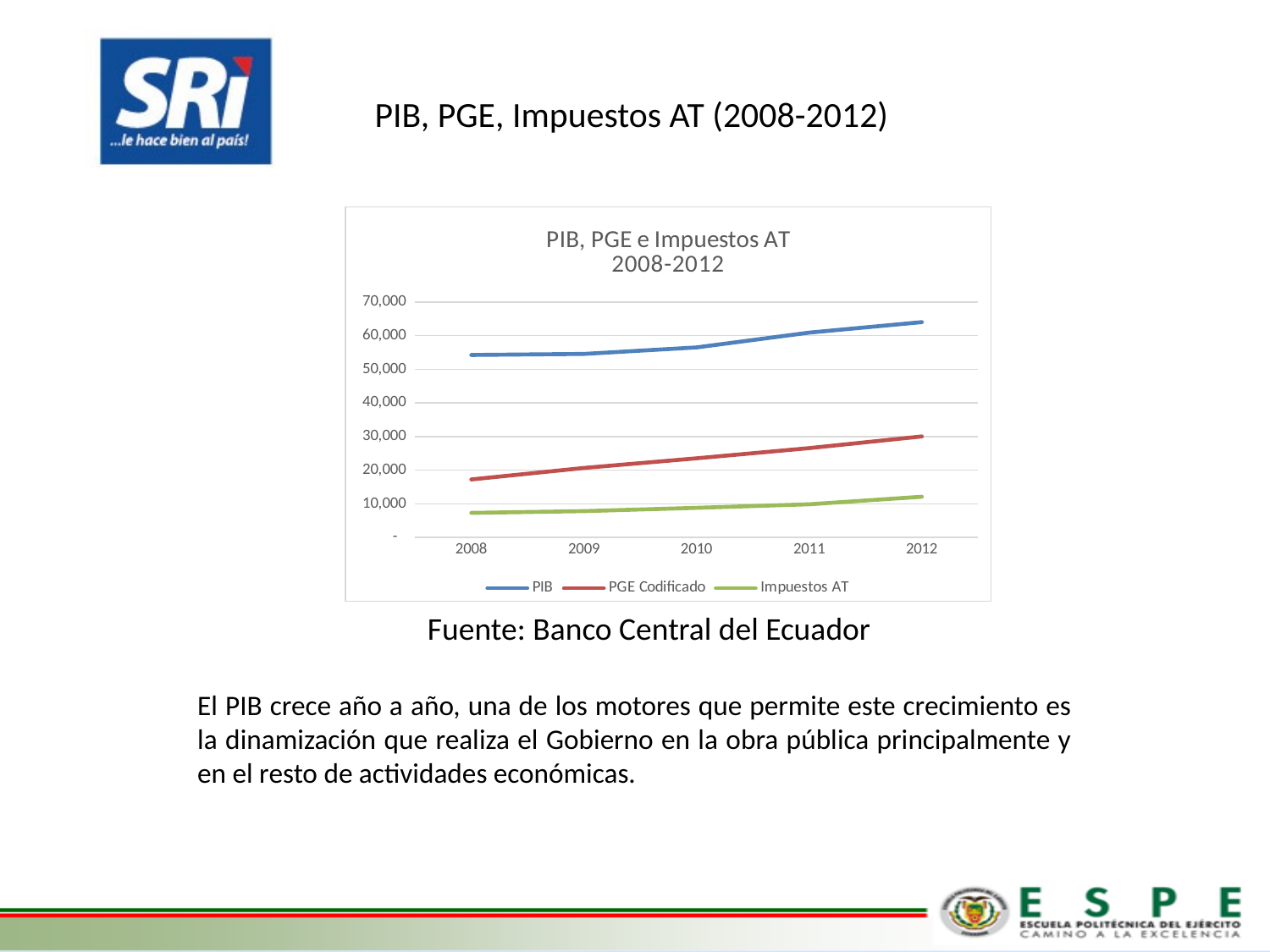
In 2012, which is larger: PIB or PGE Codificado? PIB Which series has the lowest values throughout the chart? Impuestos AT Is the value for PIB in 2012 greater or less than 60,000? greater Is the value for PGE Codificado in 2008 greater or less than 20,000? less Is the value for Impuestos AT in 2008 greater or less than 10,000? less What kind of chart is shown on the slide? line chart What is the title of the chart? PIB, PGE e Impuestos AT 2008-2012 Does the PGE Codificado line rise or fall from 2008 to 2012? rise How many years are plotted along the x axis of the chart? 5 Does the PIB line rise or fall from 2008 to 2012? rise Which series has the highest values throughout the chart? PIB How many series does the chart legend list? 3